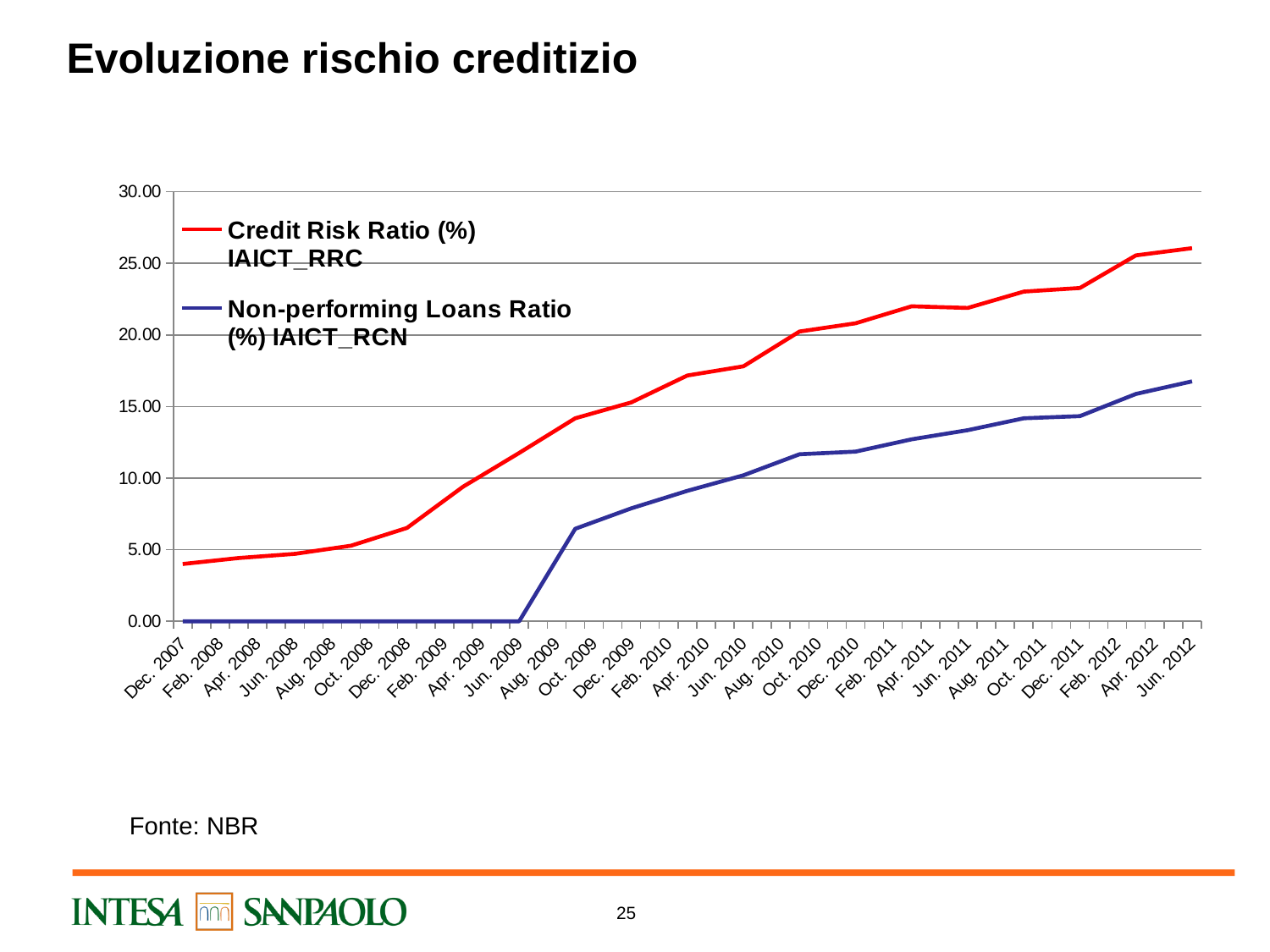
Which series reaches the highest value on the chart? Credit Risk Ratio (%) IAICT_RRC At Jun. 2012, which series has the higher value: Credit Risk Ratio (%) IAICT_RRC or Non-performing Loans Ratio (%) IAICT_RCN? Credit Risk Ratio (%) IAICT_RRC What is the value of the Non-performing Loans Ratio (%) IAICT_RCN at Dec. 2007? 0.00 What type of chart is shown on the slide? Line chart Is the value of the Credit Risk Ratio (%) IAICT_RRC at Jun. 2012 greater or less than 25.00? greater How many series does the legend list? 2 Does the Credit Risk Ratio (%) IAICT_RRC rise or fall from Dec. 2007 to Jun. 2012? Rise Is the value of the Non-performing Loans Ratio (%) IAICT_RCN at Oct. 2009 greater or less than 5.00? greater Is the value of the Non-performing Loans Ratio (%) IAICT_RCN at Jun. 2012 greater or less than 20.00? less What is the title of the slide containing the chart? Evoluzione rischio creditizio Which colour is used for the Non-performing Loans Ratio (%) IAICT_RCN line? Blue